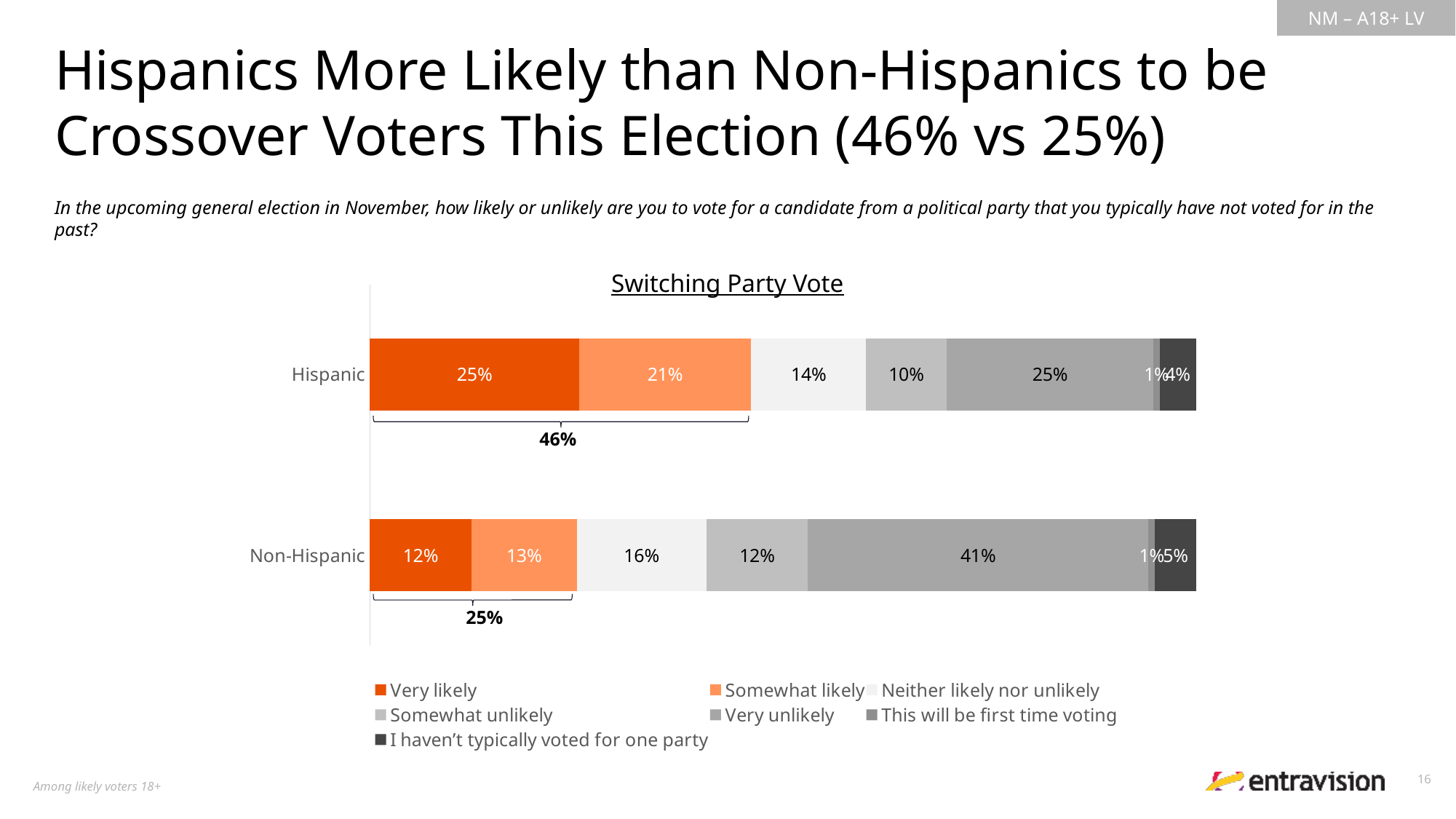
What is the difference between the 'Very unlikely' values for Non-Hispanic and Hispanic respondents? 16% What is the combined 'Very likely' plus 'Somewhat likely' share shown for Hispanic respondents? 46% Which segment is the largest in the Non-Hispanic bar? Very unlikely What is the 'Neither likely nor unlikely' value for Hispanic respondents? 14% Which group has the larger 'Very likely' value, Hispanic or Non-Hispanic? Hispanic What is the title of the chart? Switching Party Vote How many series does the legend list? 7 What type of chart is shown on the slide? Stacked bar chart What is the 'Somewhat likely' value for Non-Hispanic respondents? 13% What percentage of Non-Hispanic respondents are 'Very unlikely' to switch party vote? 41% What percentage of Hispanic respondents are 'Very likely' to switch party vote? 25% How many categories (bars) are plotted in the chart? 2